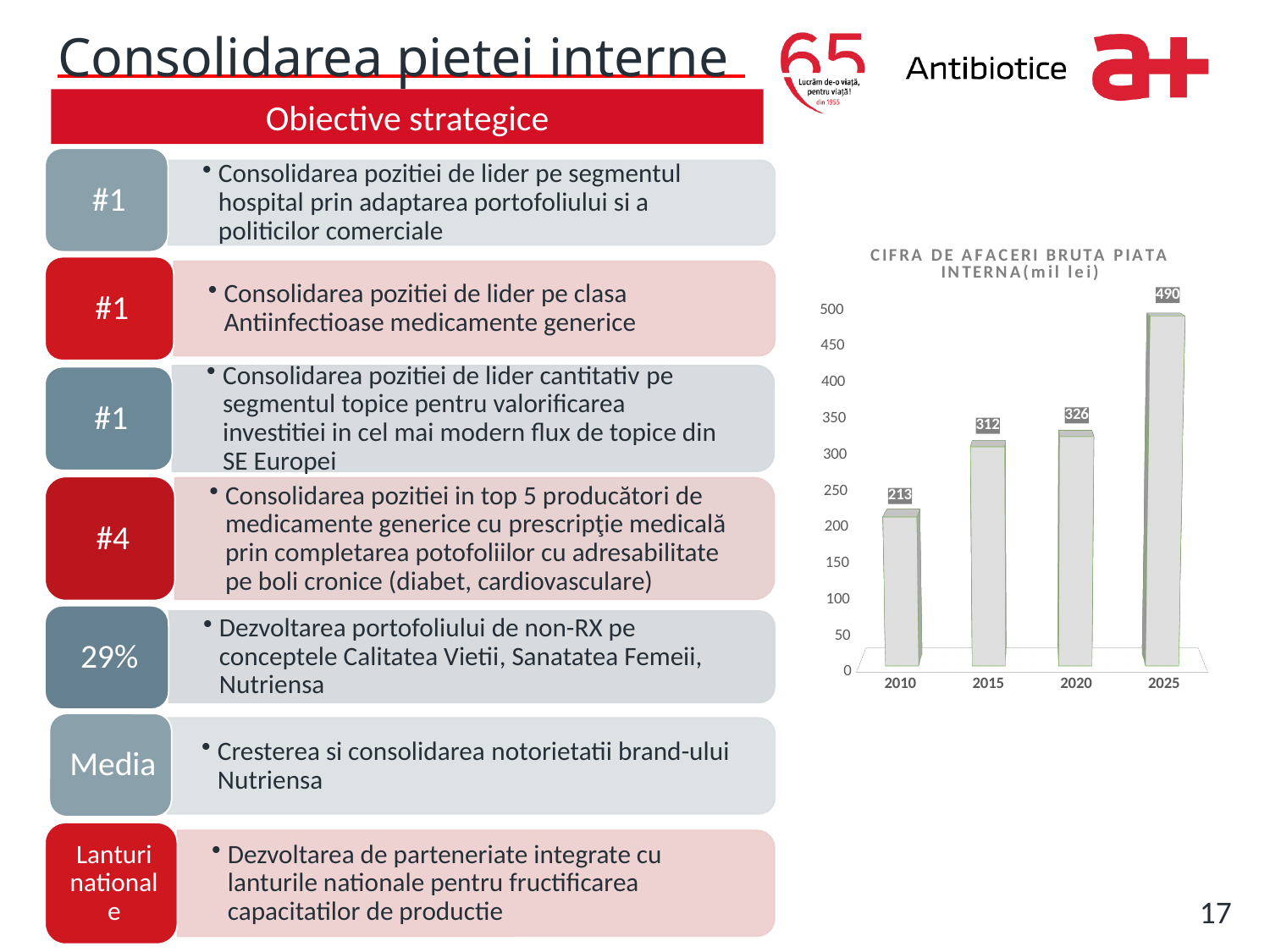
What is the value for 2025 in the chart? 490 Which year has the lowest value in the chart? 2010 How many years are shown on the x axis of the chart? 4 What is the value for 2020 in the chart? 326 What is the difference between the values for 2020 and 2015? 14 What is the difference between the values for 2025 and 2010? 277 Which is larger, the value for 2015 or the value for 2010? 2015 What kind of chart is shown on the slide? bar chart What is the title of the chart? CIFRA DE AFACERI BRUTA PIATA INTERNA(mil lei) Which year has the highest value in the chart? 2025 What is the value for 2015 in the chart? 312 What is the value for 2010 in the chart? 213